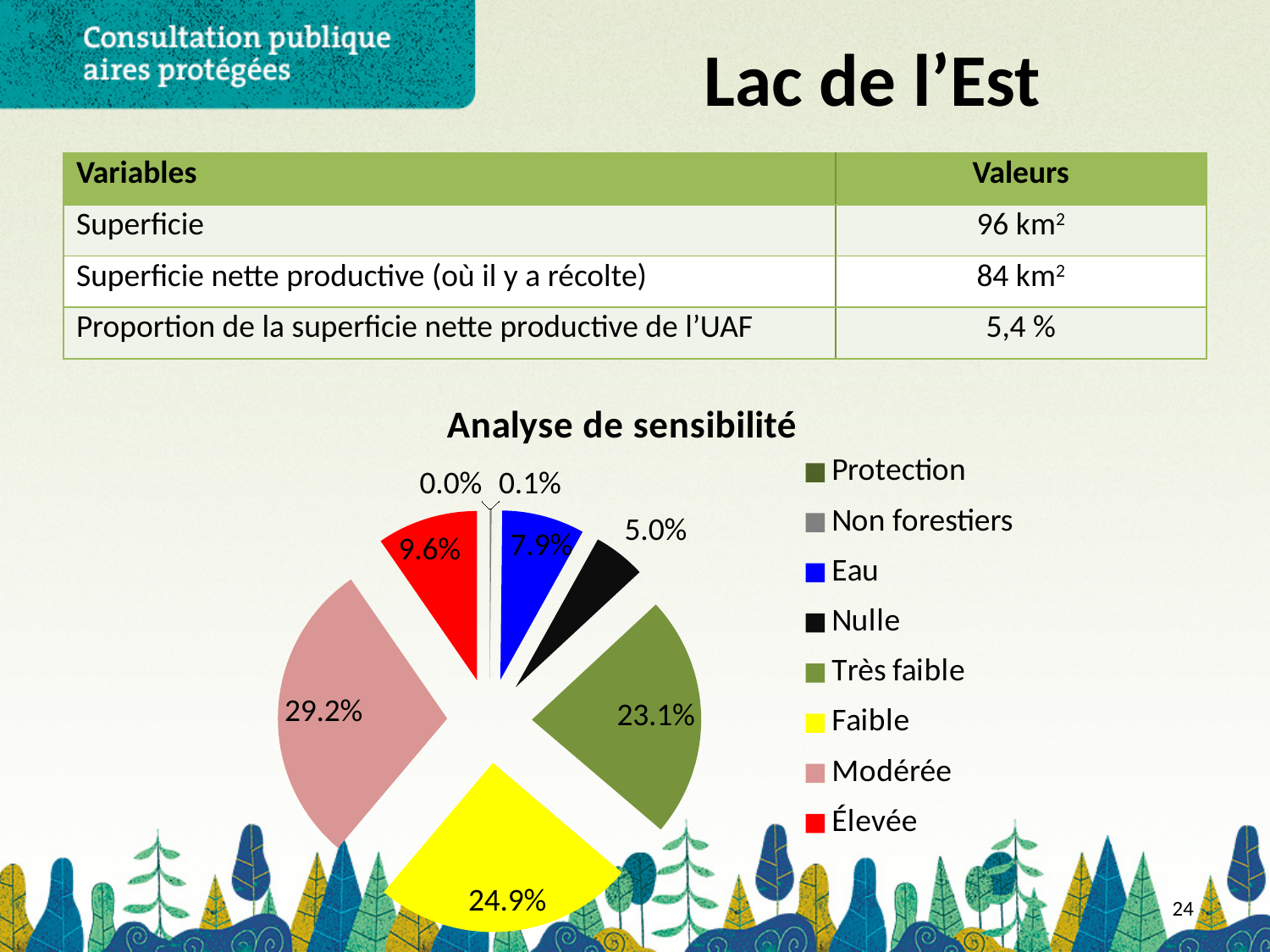
In the "Analyse de sensibilité" pie chart, what is the share for Très faible? 23.1% In the "Analyse de sensibilité" pie chart, which category has the smallest share? Protection In the "Analyse de sensibilité" pie chart, which category has the largest share? Modérée In the "Analyse de sensibilité" pie chart, what is the share for Faible? 24.9% In the "Analyse de sensibilité" pie chart, what is the share for Eau? 7.9% In the "Analyse de sensibilité" pie chart, which is larger, the share for Élevée or the share for Eau? Élevée In the "Analyse de sensibilité" pie chart, what is the share for Nulle? 5.0% In the "Analyse de sensibilité" pie chart, what is the share for Élevée? 9.6% In the "Analyse de sensibilité" pie chart, what is the difference between the shares for Modérée and Faible? 4.3% How many categories does the legend of the "Analyse de sensibilité" pie chart list? 8 What kind of chart is shown under the title "Analyse de sensibilité"? pie chart In the "Analyse de sensibilité" pie chart, what is the share for Modérée? 29.2%